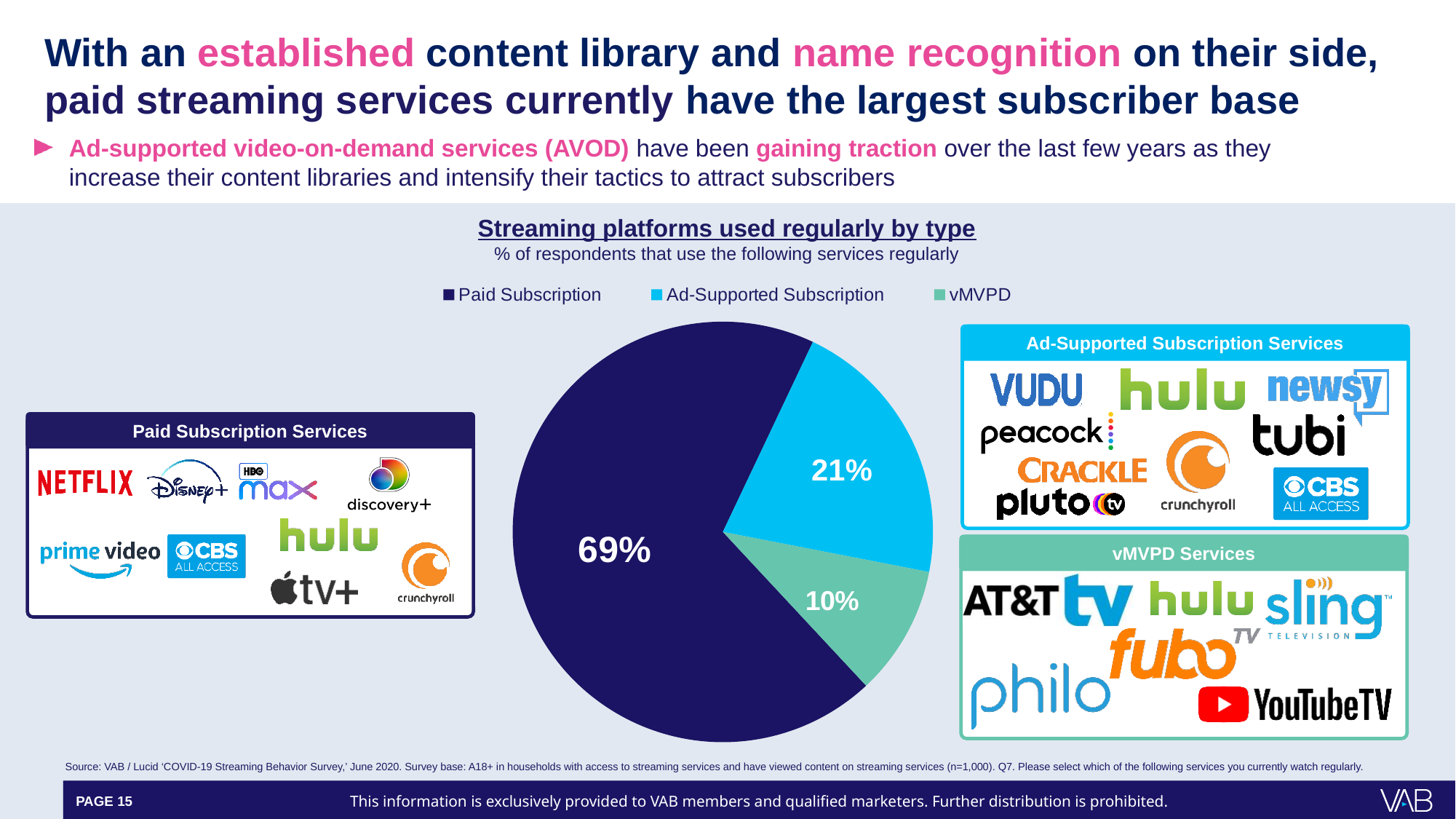
How many categories does the pie chart show? 3 What type of chart is shown on the slide? Pie chart What is the difference in percentage points between Paid Subscription and Ad-Supported Subscription? 48 What is the difference in percentage points between Ad-Supported Subscription and vMVPD? 11 Which is larger, the share for Ad-Supported Subscription or the share for vMVPD? Ad-Supported Subscription What is the title of the chart? Streaming platforms used regularly by type What percentage of respondents use vMVPD services regularly? 10% What percentage of respondents use Paid Subscription services regularly? 69% Which streaming platform type has the smallest share of the pie? vMVPD Which streaming platform type has the largest share of the pie? Paid Subscription What percentage of respondents use Ad-Supported Subscription services regularly? 21% How many entries does the legend list? 3